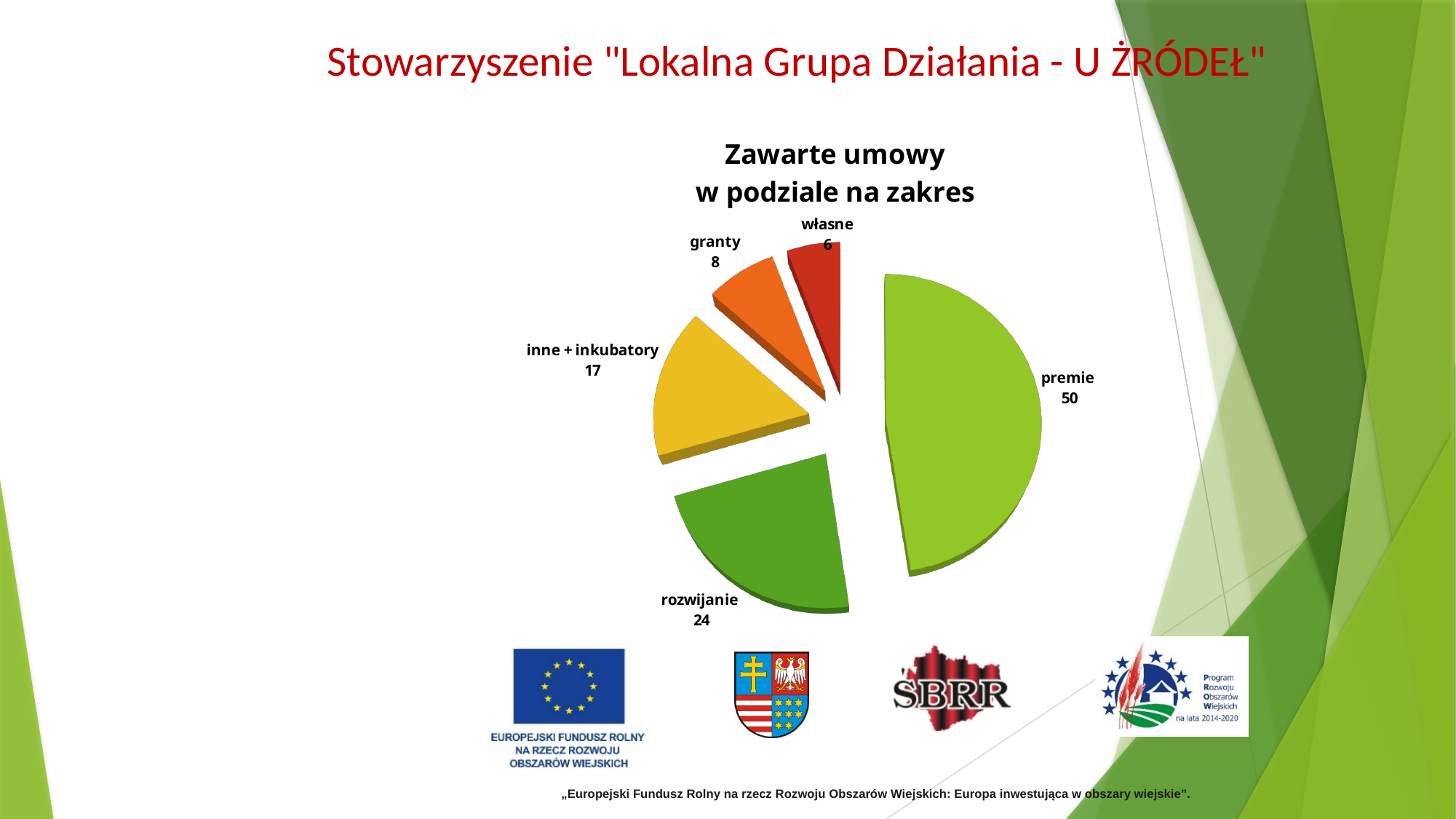
What is the value for granty in the pie chart? 8 Which category has the largest slice in the pie chart? premie What is the difference between the values for premie and rozwijanie? 26 What is the title of the chart? Zawarte umowy w podziale na zakres Which category has the smallest slice in the pie chart? własne What is the value for inne + inkubatory in the pie chart? 17 What is the value for rozwijanie in the pie chart? 24 What type of chart is shown on the slide? pie chart How many categories are shown in the pie chart? 5 Which is larger, the value for inne + inkubatory or the value for granty? inne + inkubatory What is the value for premie in the pie chart? 50 What is the value for własne in the pie chart? 6